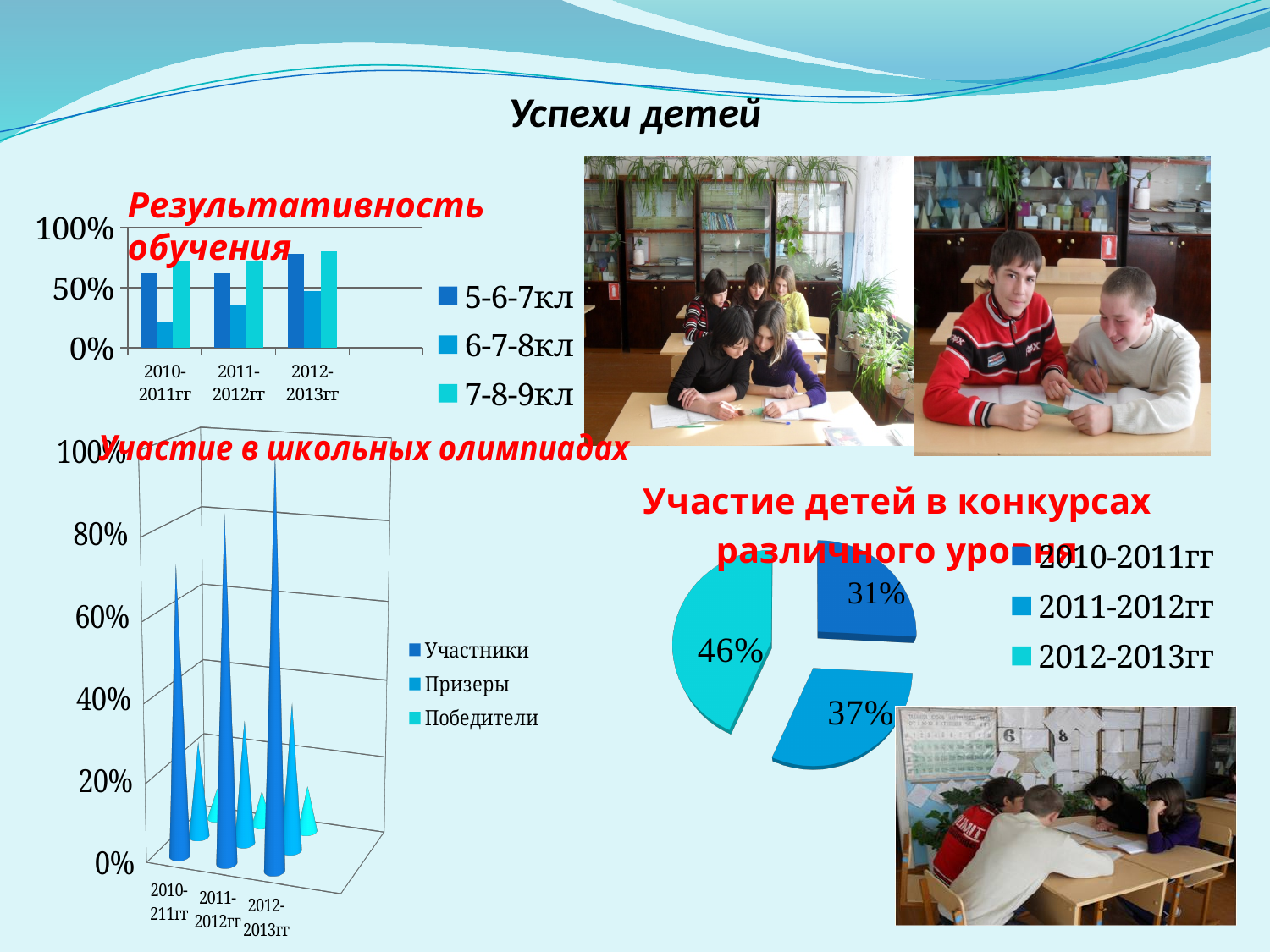
In the chart 'Результативность обучения', is the value for 6-7-8кл in 2010-2011гг greater or less than 50%? less In the pie chart 'Участие детей в конкурсах различного уровня', which year has the smallest slice? 2010-2011гг In the pie chart 'Участие детей в конкурсах различного уровня', which year has the largest slice? 2012-2013гг In the chart 'Участие в школьных олимпиадах', is the value for Участники in 2010-2011гг greater or less than 60%? greater In the pie chart 'Участие детей в конкурсах различного уровня', what share is shown for 2012-2013гг? 46% How many series does the legend of the chart 'Результативность обучения' list? 3 What kind of chart is 'Результативность обучения'? bar chart In the pie chart 'Участие детей в конкурсах различного уровня', what share is shown for 2011-2012гг? 37% In the pie chart 'Участие детей в конкурсах различного уровня', what share is shown for 2010-2011гг? 31% In the chart 'Участие в школьных олимпиадах', which series does the legend list first? Участники In the chart 'Результативность обучения', is the value for 7-8-9кл in 2012-2013гг greater or less than 50%? greater In the pie chart 'Участие детей в конкурсах различного уровня', what is the difference between the 2012-2013гг share and the 2010-2011гг share? 15%